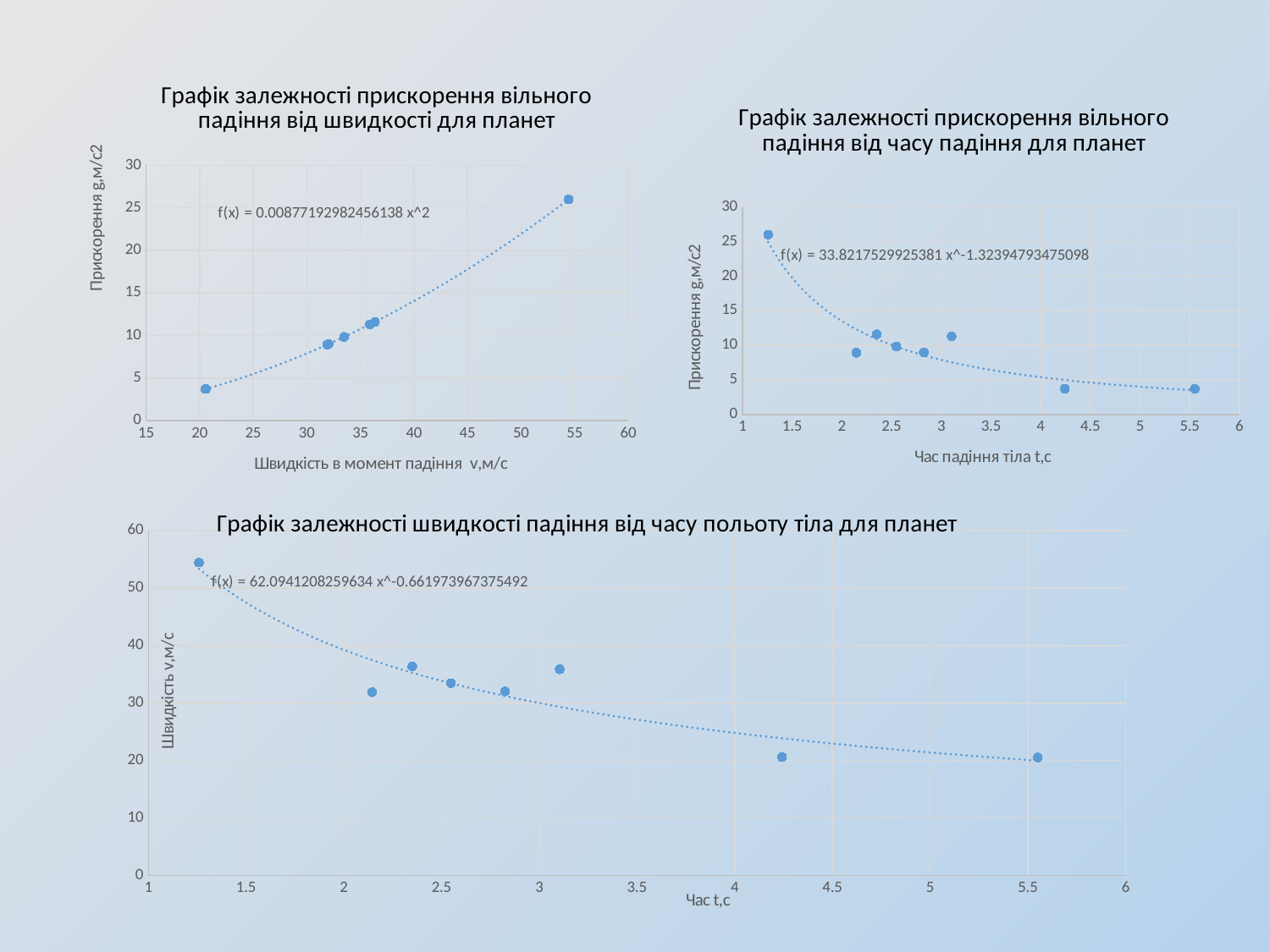
In the bottom chart (speed vs. flight time), do the values rise or fall as time increases along the x axis? Fall What kind of chart is the top-left chart titled 'Графік залежності прискорення вільного падіння від швидкості для планет'? Scatter chart In the top-left chart, is the acceleration value for the point at the lowest speed (around 20 m/s) greater or less than 5? less What trendline equation is shown on the top-left chart (acceleration vs. speed)? f(x) = 0.00877192982456138 x^2 How many data points are plotted in the bottom chart (speed vs. flight time)? 8 In the top-left chart, is the acceleration value for the point at the highest speed (around 55 m/s) greater or less than 20? greater In the top-left chart (acceleration vs. speed), do the values rise or fall as speed increases along the x axis? Rise In the top-right chart (acceleration vs. fall time), do the values rise or fall as time increases along the x axis? Fall In the bottom chart, is the speed value for the point at the shortest time (around 1.25 s) greater or less than 50? greater How many data points are plotted in the top-right chart (acceleration vs. fall time)? 8